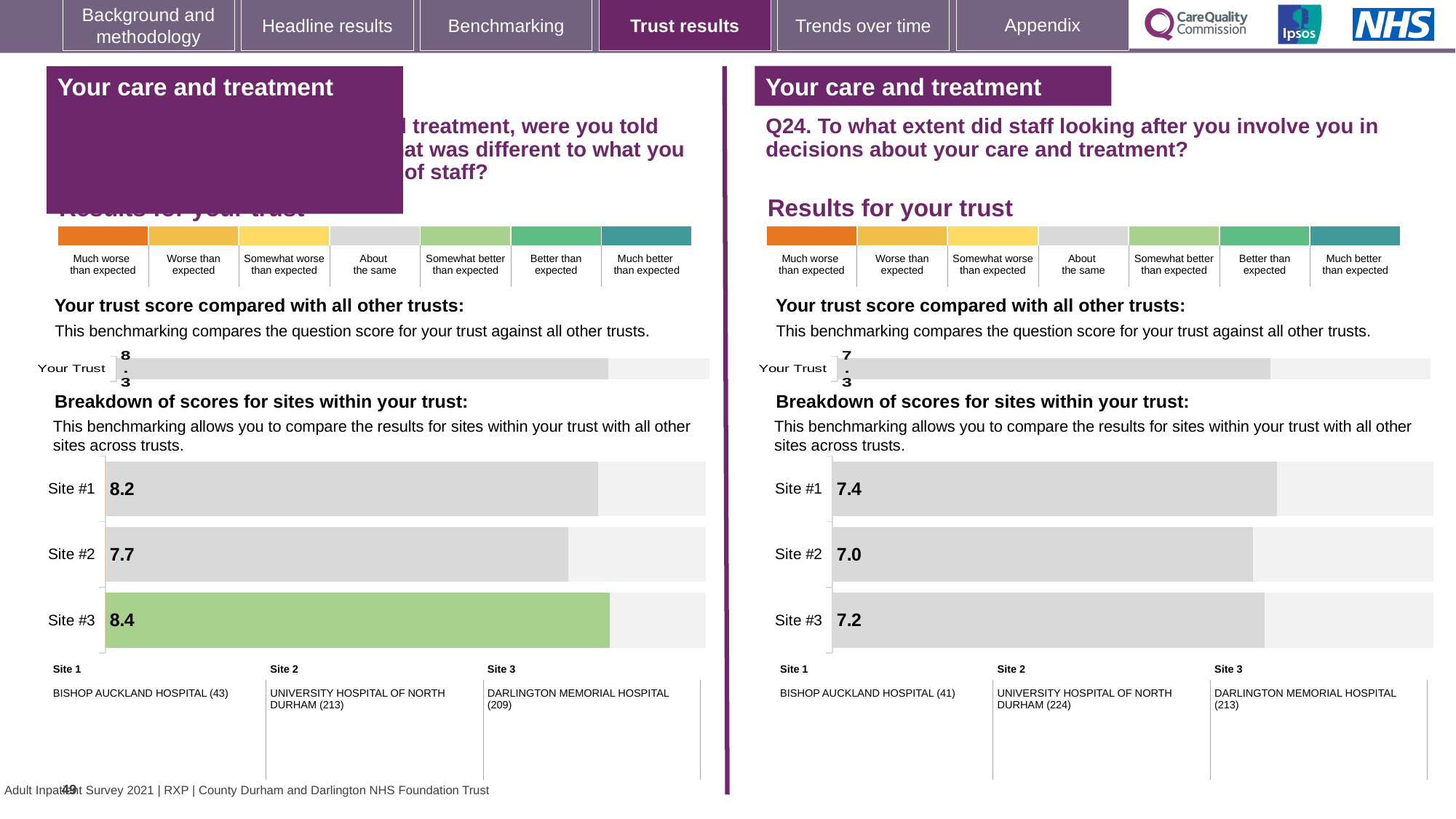
In the left-hand 'Breakdown of scores for sites within your trust' chart, what is the score for Site #3? 8.4 In the left-hand site breakdown chart, which site has the highest score? Site #3 In the right-hand (Q24) 'Breakdown of scores for sites within your trust' chart, what is the score for Site #1? 7.4 In the right-hand (Q24) 'Breakdown of scores for sites within your trust' chart, what is the score for Site #2? 7.0 In the right-hand (Q24) site breakdown chart, which site has the lowest score? Site #2 In the left-hand 'Breakdown of scores for sites within your trust' chart, what is the score for Site #2? 7.7 How many sites are shown in the left-hand site breakdown chart? 3 In the left-hand site breakdown chart, what is the difference between the scores for Site #3 and Site #2? 0.7 What type of chart is used for the site breakdown on the right-hand (Q24) panel? Bar chart In the left-hand site breakdown chart, which site's bar is coloured green? Site #3 In the right-hand (Q24) site breakdown chart, what is the difference between the scores for Site #1 and Site #3? 0.2 In the right-hand (Q24) site breakdown chart, which has the higher score, Site #1 or Site #3? Site #1